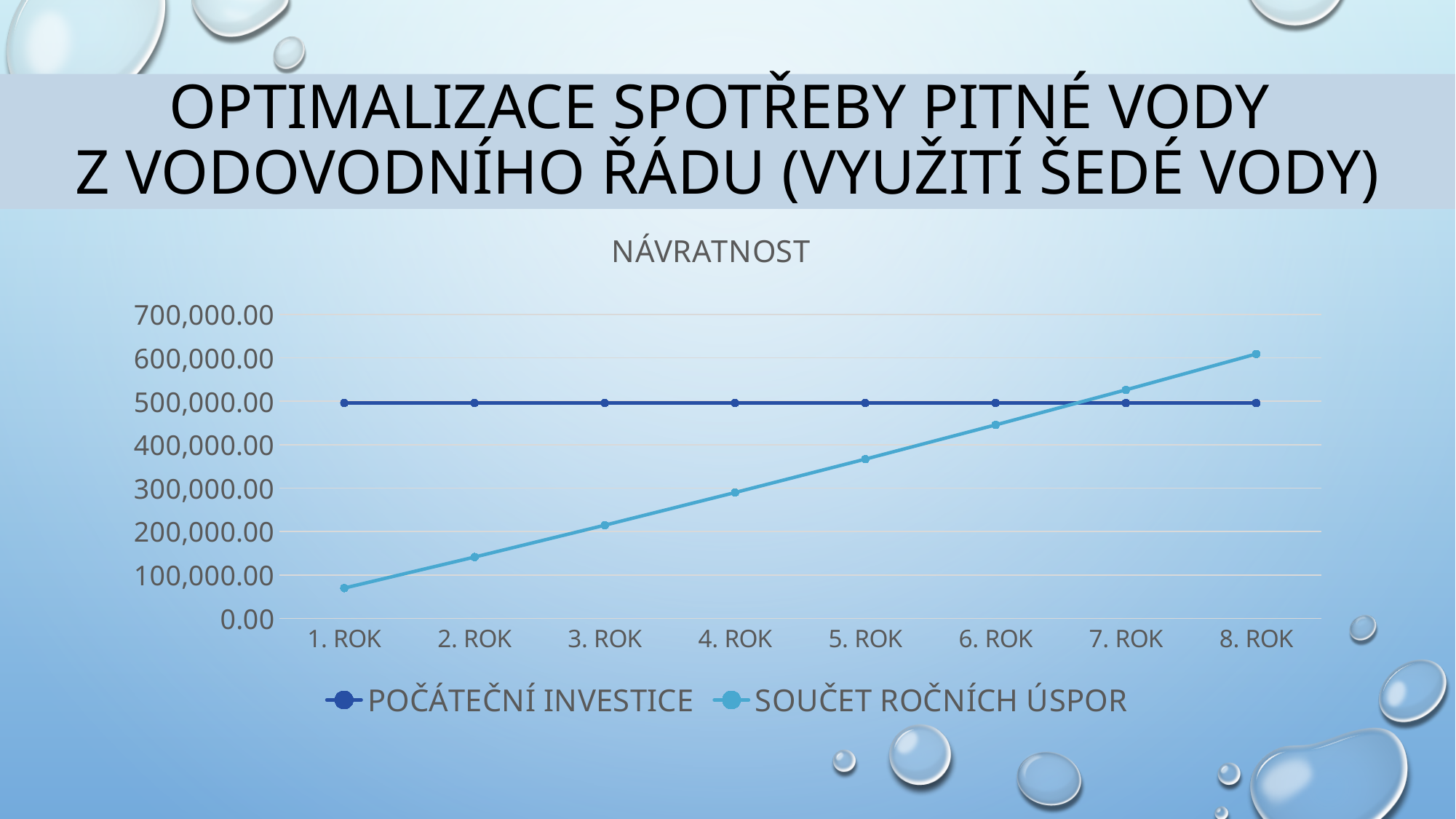
In which year is the value of SOUČET ROČNÍCH ÚSPOR lowest? 1. ROK What is the title of the chart? NÁVRATNOST Is the value of SOUČET ROČNÍCH ÚSPOR at 1. ROK greater or less than 100,000.00? less Is the value of SOUČET ROČNÍCH ÚSPOR at 6. ROK greater or less than 400,000.00? greater Do the values of SOUČET ROČNÍCH ÚSPOR rise or fall from 1. ROK to 8. ROK? rise In which year is the value of SOUČET ROČNÍCH ÚSPOR highest? 8. ROK What kind of chart is shown on the slide? line chart At 8. ROK, which series has the larger value, POČÁTEČNÍ INVESTICE or SOUČET ROČNÍCH ÚSPOR? SOUČET ROČNÍCH ÚSPOR How many categories are shown on the x axis? 8 Which series is shown in the lighter blue colour? SOUČET ROČNÍCH ÚSPOR How many series does the legend list? 2